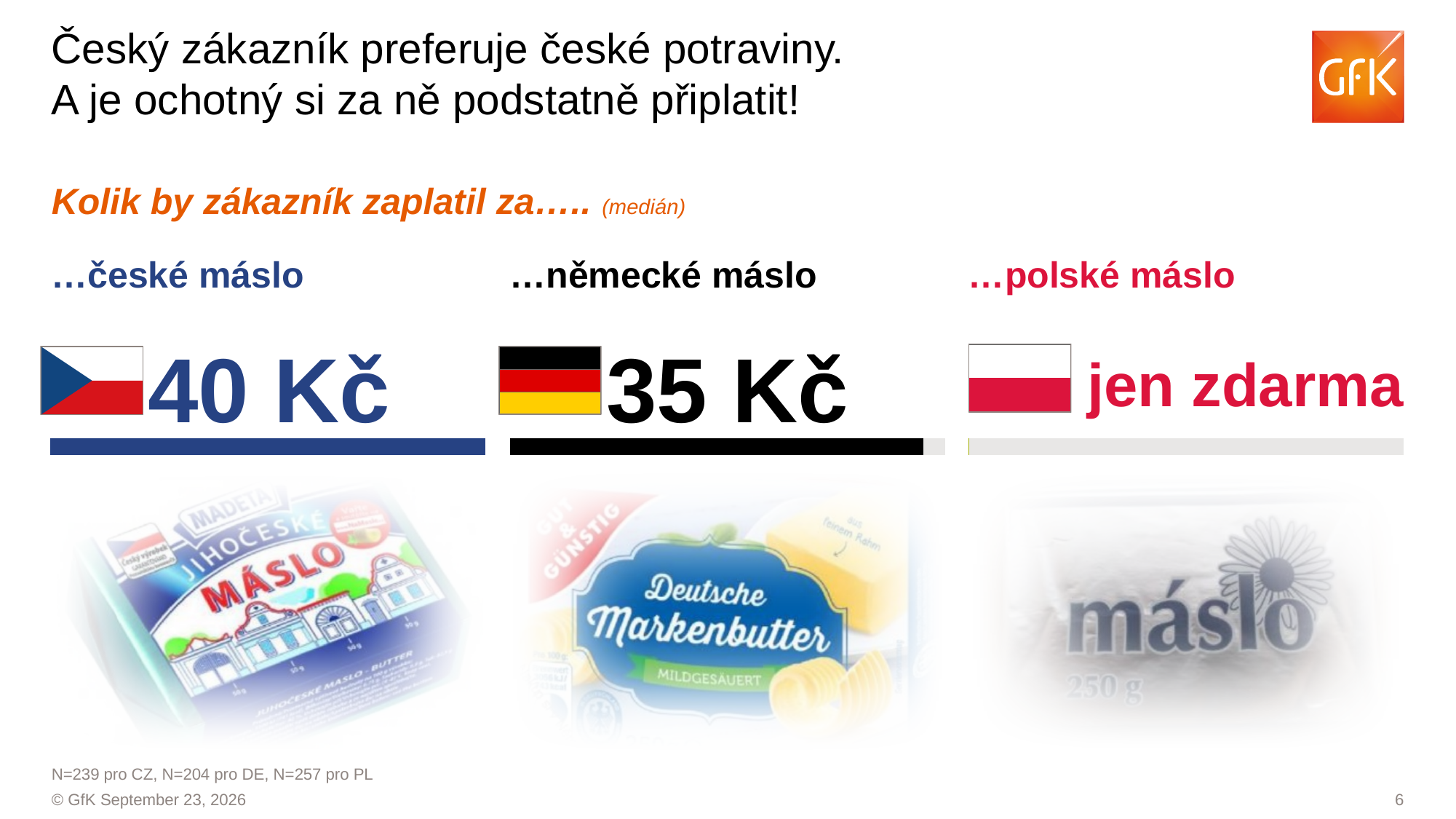
How many types of butter are compared on the slide? 3 Which is larger, the median price for Czech butter or for German butter? Czech butter (40 Kč) What is the sample size (N) for the Czech butter (CZ) question? 239 Which butter has the lowest value shown? polské máslo What is the sample size (N) for the Polish butter (PL) question? 257 What median price would the customer pay for German butter (německé máslo)? 35 Kč Which butter has the highest median price the customer would pay? české máslo What is shown as the amount the customer would pay for Polish butter (polské máslo)? jen zdarma What is the difference between the median price for Czech butter and German butter? 5 Kč What median price would the customer pay for Czech butter (české máslo)? 40 Kč